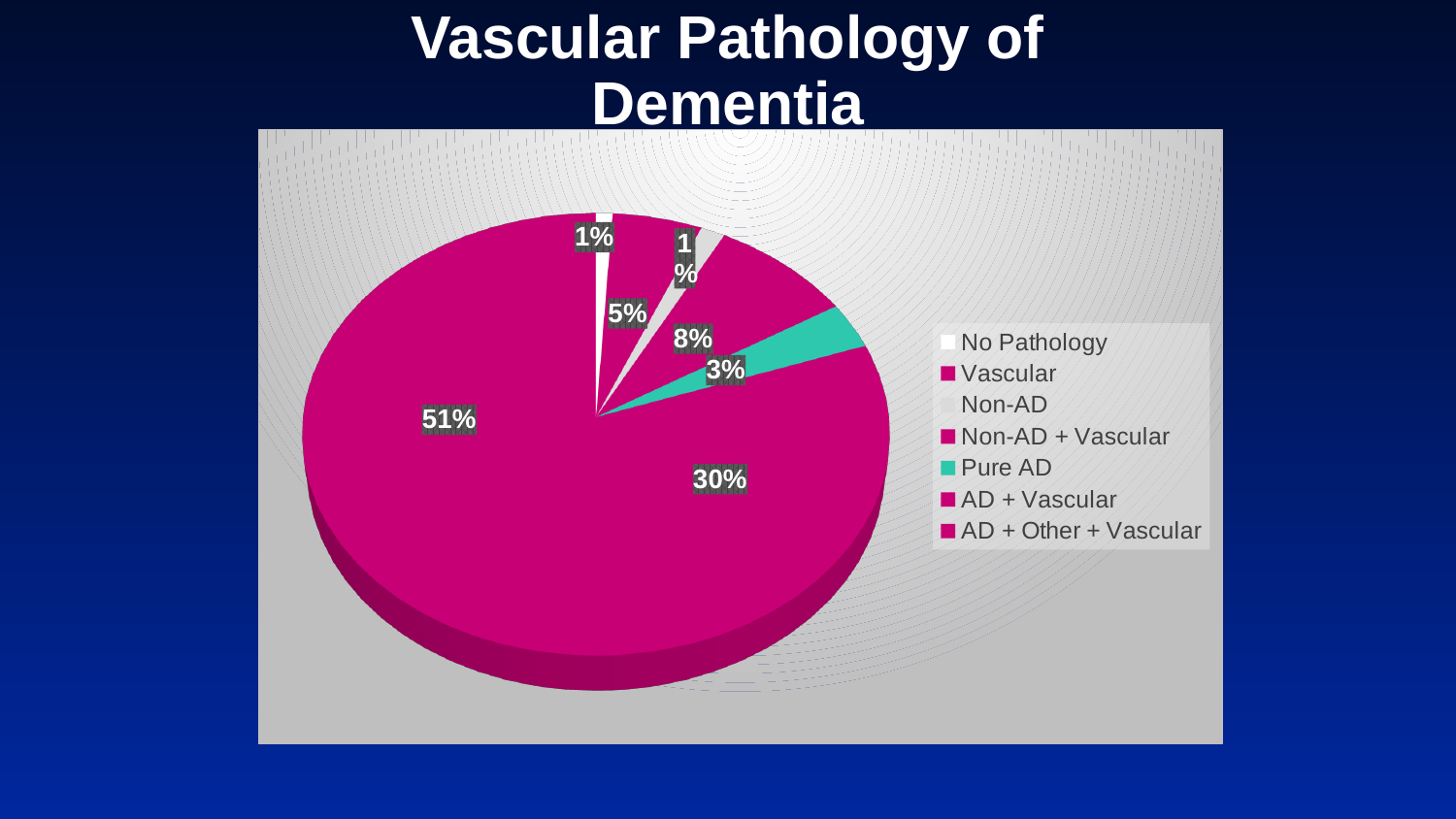
What percentage of the pie is Pure AD? 3% What colour is the Pure AD slice? teal What is the smallest percentage shown on the pie chart? 1% What kind of chart is shown on the slide? pie chart How many entries does the legend list? 7 Which slice is larger, Pure AD or No Pathology? Pure AD What is the difference in percentage points between the largest slice (51%) and the second largest slice (30%)? 21 What is the largest percentage shown on the pie chart? 51% What percentage of the pie is No Pathology? 1% How many slices does the pie chart have? 7 What percentage of the pie is Non-AD? 1% What is the title of the chart? Vascular Pathology of Dementia